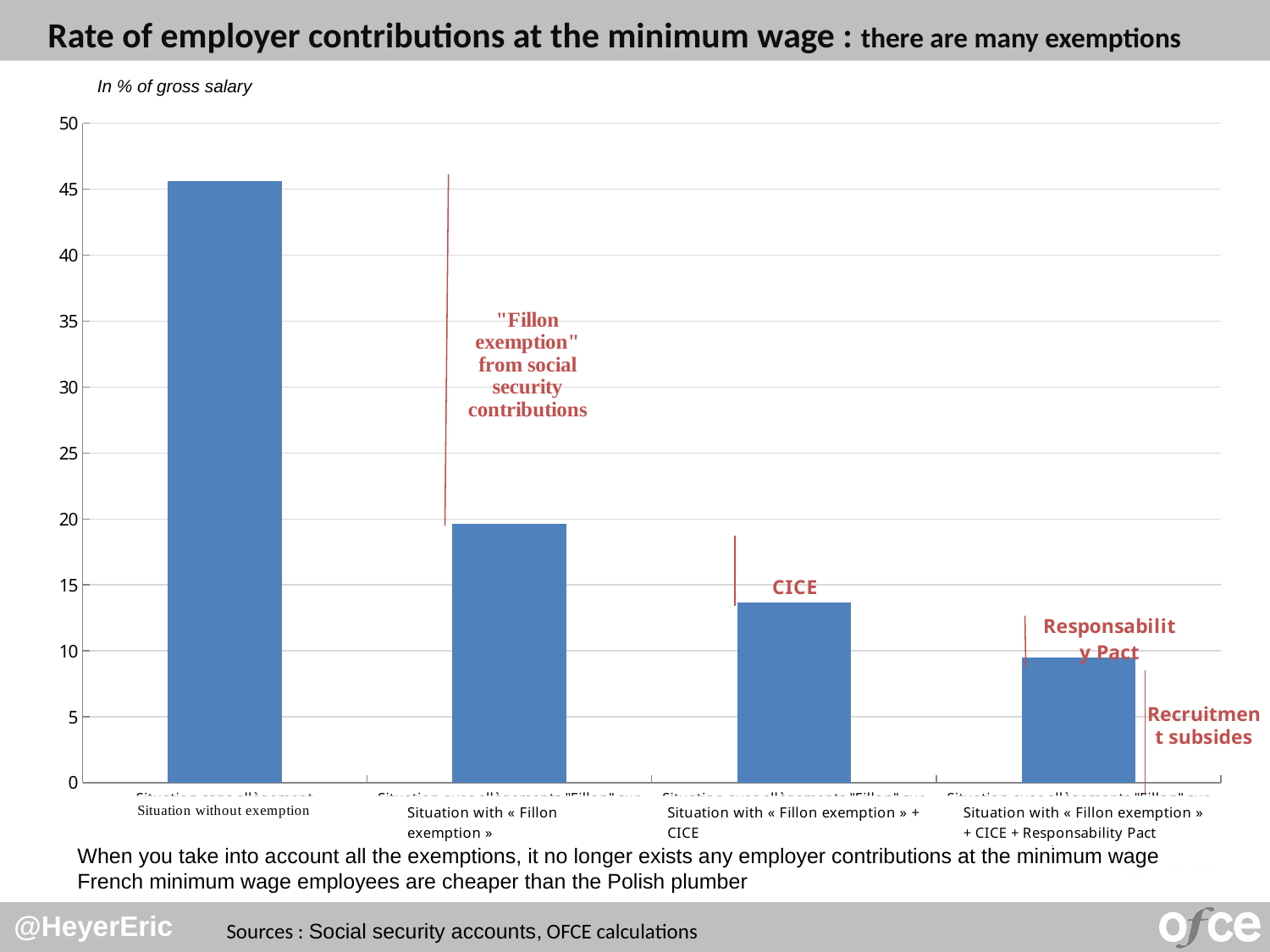
Do the values rise or fall from left to right across the categories? fall Which category has the lowest rate of employer contributions? Situation with « Fillon exemption » + CICE + Responsability Pact How many bars (categories) does the chart show? 4 What kind of chart is shown on the slide? bar chart Which category has the highest rate of employer contributions? Situation without exemption Is the value for 'Situation without exemption' greater or less than 45? greater Is the value for 'Situation with « Fillon exemption » + CICE' greater or less than 15? less Which is larger: the value for 'Situation with « Fillon exemption »' or the value for 'Situation with « Fillon exemption » + CICE'? Situation with « Fillon exemption » What is the maximum value shown on the vertical axis? 50 Is the value for 'Situation with « Fillon exemption » + CICE + Responsability Pact' greater or less than 10? less In what unit are the values on the chart expressed, according to the note above the chart? In % of gross salary